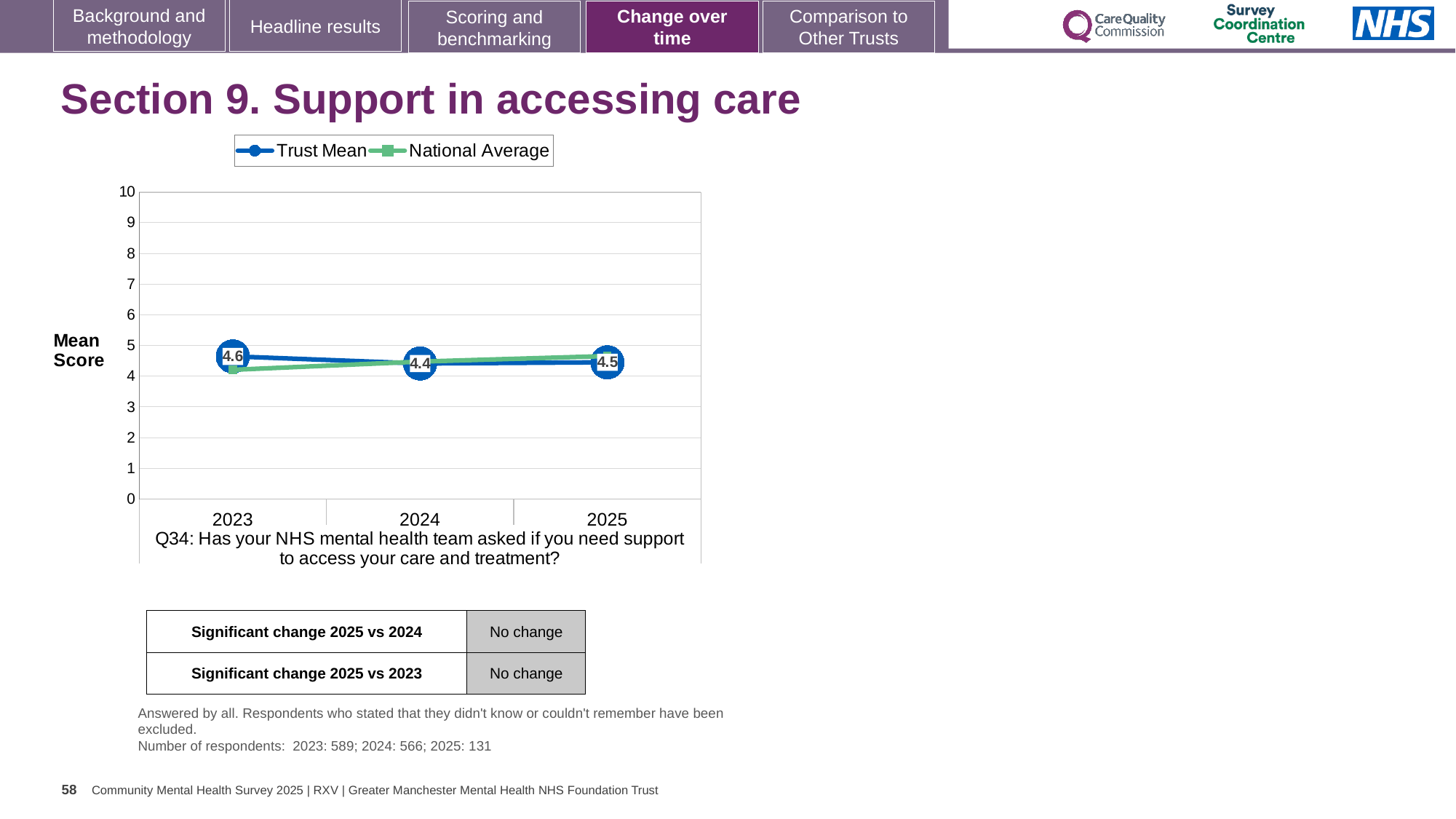
What is the Trust Mean score for 2023? 4.6 What is the Trust Mean score for 2025? 4.5 Does the National Average rise or fall from 2023 to 2025? rise Is the National Average value for 2023 greater or less than 5? less How many years are plotted on the x axis? 3 In which year is the Trust Mean lowest? 2024 What kind of chart is shown? line chart What is the difference between the Trust Mean in 2023 and in 2024? 0.2 How many series does the legend list? 2 Which year has the larger Trust Mean, 2023 or 2025? 2023 What is the Trust Mean score for 2024? 4.4 In which year is the Trust Mean highest? 2023